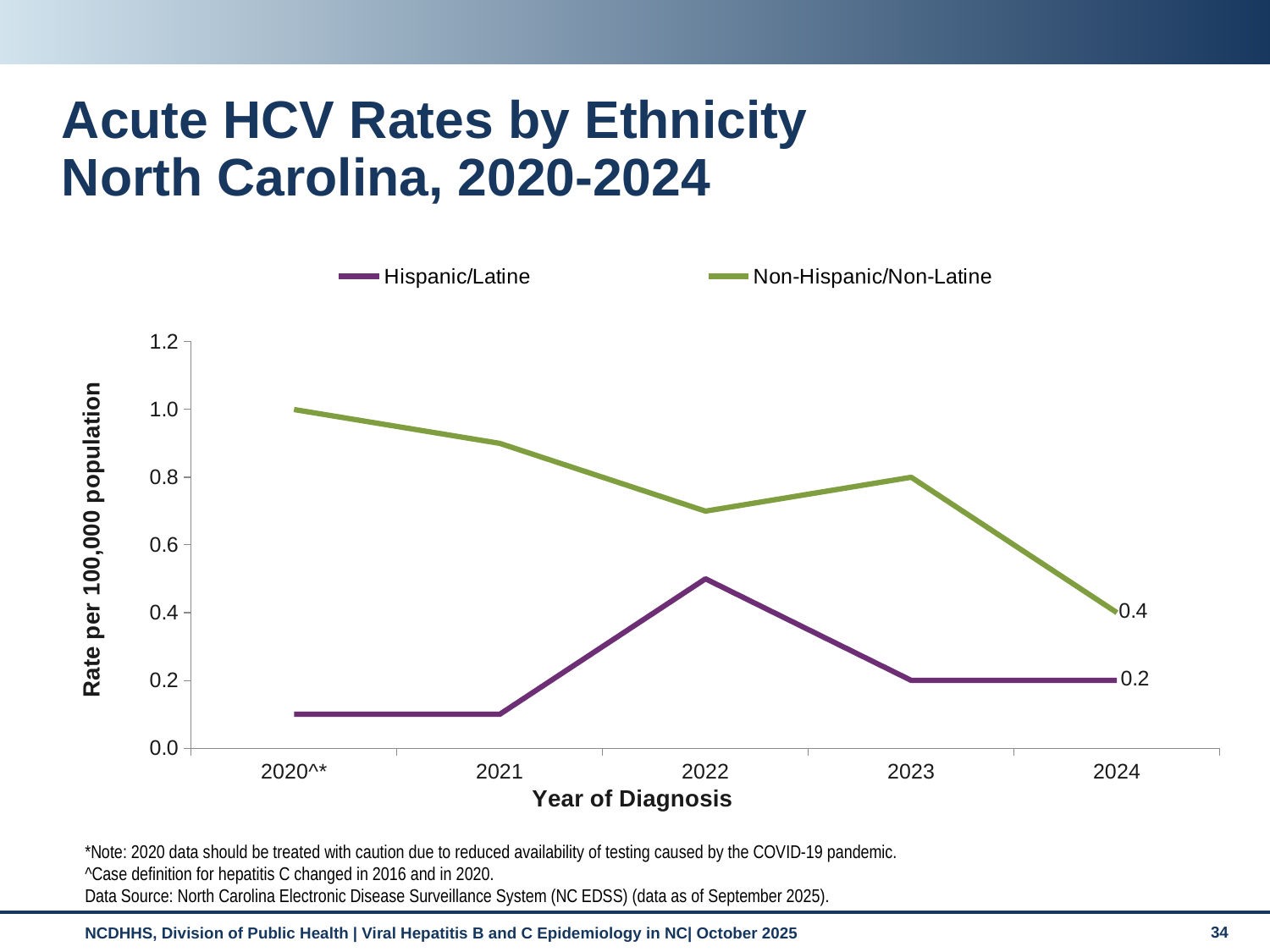
What is the Non-Hispanic/Non-Latine rate in 2020? 1.0 What is the Hispanic/Latine rate in 2024? 0.2 How many years are plotted along the x axis? 5 Does the Non-Hispanic/Non-Latine rate rise or fall from 2020 to 2024? fall What kind of chart is shown on the slide? line chart Is the Non-Hispanic/Non-Latine rate in 2022 greater or less than 0.8? less How many series does the legend list? 2 What is the difference between the Non-Hispanic/Non-Latine and Hispanic/Latine rates in 2024? 0.2 What is the Non-Hispanic/Non-Latine rate in 2024? 0.4 In which year is the Non-Hispanic/Non-Latine rate highest? 2020 Is the Hispanic/Latine rate in 2022 greater or less than 0.4? greater In which year is the Hispanic/Latine rate highest? 2022